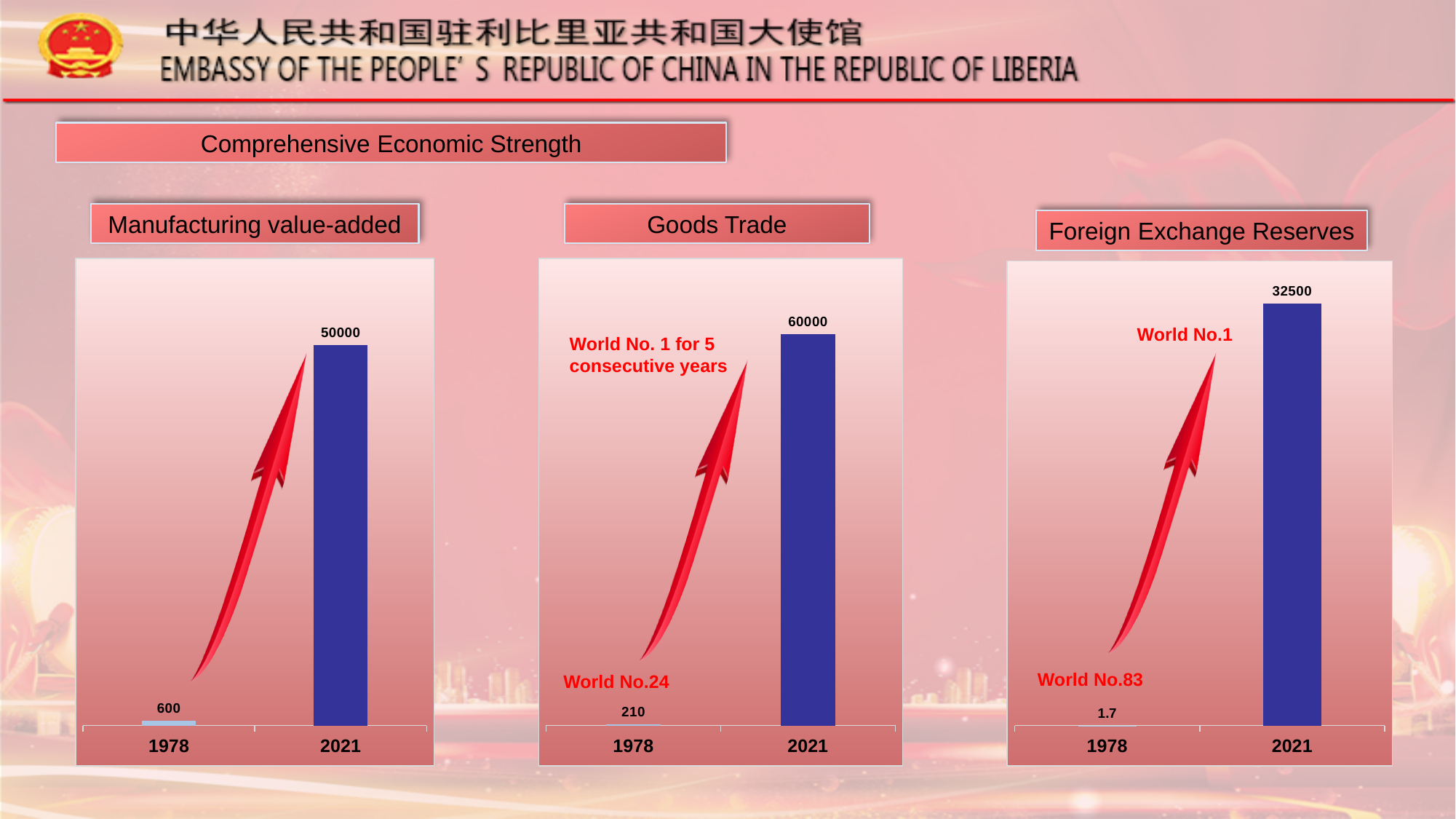
In the Goods Trade chart, what is the value for 2021? 60000 What kind of chart is the Manufacturing value-added chart? Bar chart In the Goods Trade chart, what is the difference between the 2021 and 1978 values? 59790 In the Goods Trade chart, what is the value for 1978? 210 In the Foreign Exchange Reserves chart, which year has the higher value? 2021 In the Foreign Exchange Reserves chart, what is the value for 2021? 32500 How many categories are shown on the x axis of the Goods Trade chart? 2 In the Manufacturing value-added chart, what is the difference between the 2021 and 1978 values? 49400 In the Manufacturing value-added chart, what is the value for 2021? 50000 In the Goods Trade chart, what world ranking is annotated for 1978? World No.24 In the Manufacturing value-added chart, what is the value for 1978? 600 In the Foreign Exchange Reserves chart, what is the value for 1978? 1.7